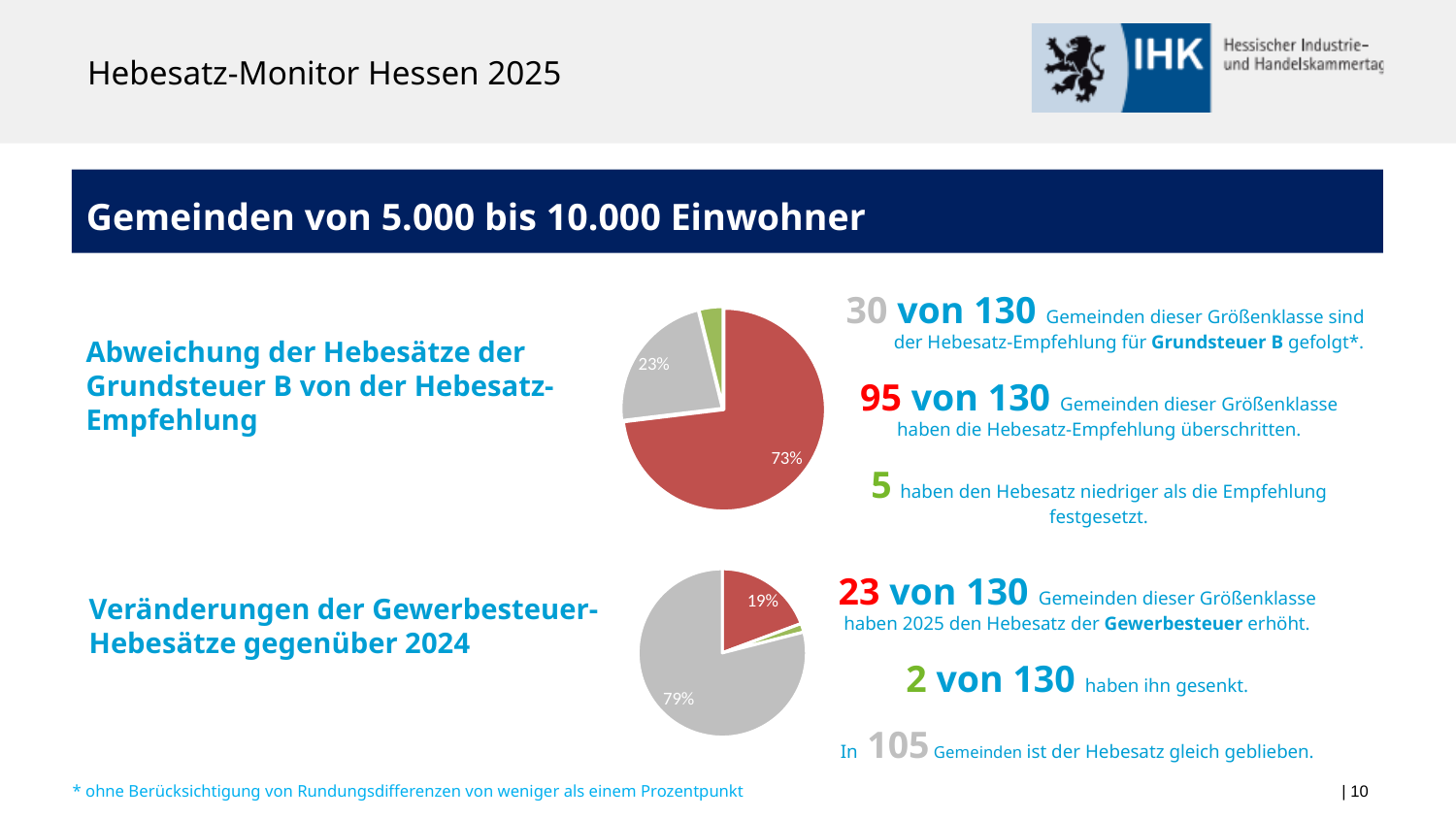
How many slices does the upper pie chart (Grundsteuer B) have? 3 What kind of chart is the lower chart next to 'Veränderungen der Gewerbesteuer-Hebesätze gegenüber 2024'? Pie chart What kind of chart is the upper chart next to 'Abweichung der Hebesätze der Grundsteuer B von der Hebesatz-Empfehlung'? Pie chart In the lower pie chart (Gewerbesteuer), what percentage is shown for the grey slice? 79% In the upper pie chart (Grundsteuer B), what is the difference in percentage points between the red slice and the grey slice? 50 percentage points In the upper pie chart (Grundsteuer B), what percentage is shown for the red slice? 73% In the upper pie chart (Grundsteuer B), what percentage is shown for the grey slice? 23% In the lower pie chart (Gewerbesteuer), what percentage is shown for the red slice? 19% In the upper pie chart (Grundsteuer B), which is larger, the red slice or the grey slice? The red slice In the lower pie chart (Gewerbesteuer), which slice is the smallest? The green slice In the upper pie chart (Grundsteuer B), which slice is the largest? The red slice (73%) In the lower pie chart (Gewerbesteuer), what is the difference in percentage points between the grey slice and the red slice? 60 percentage points